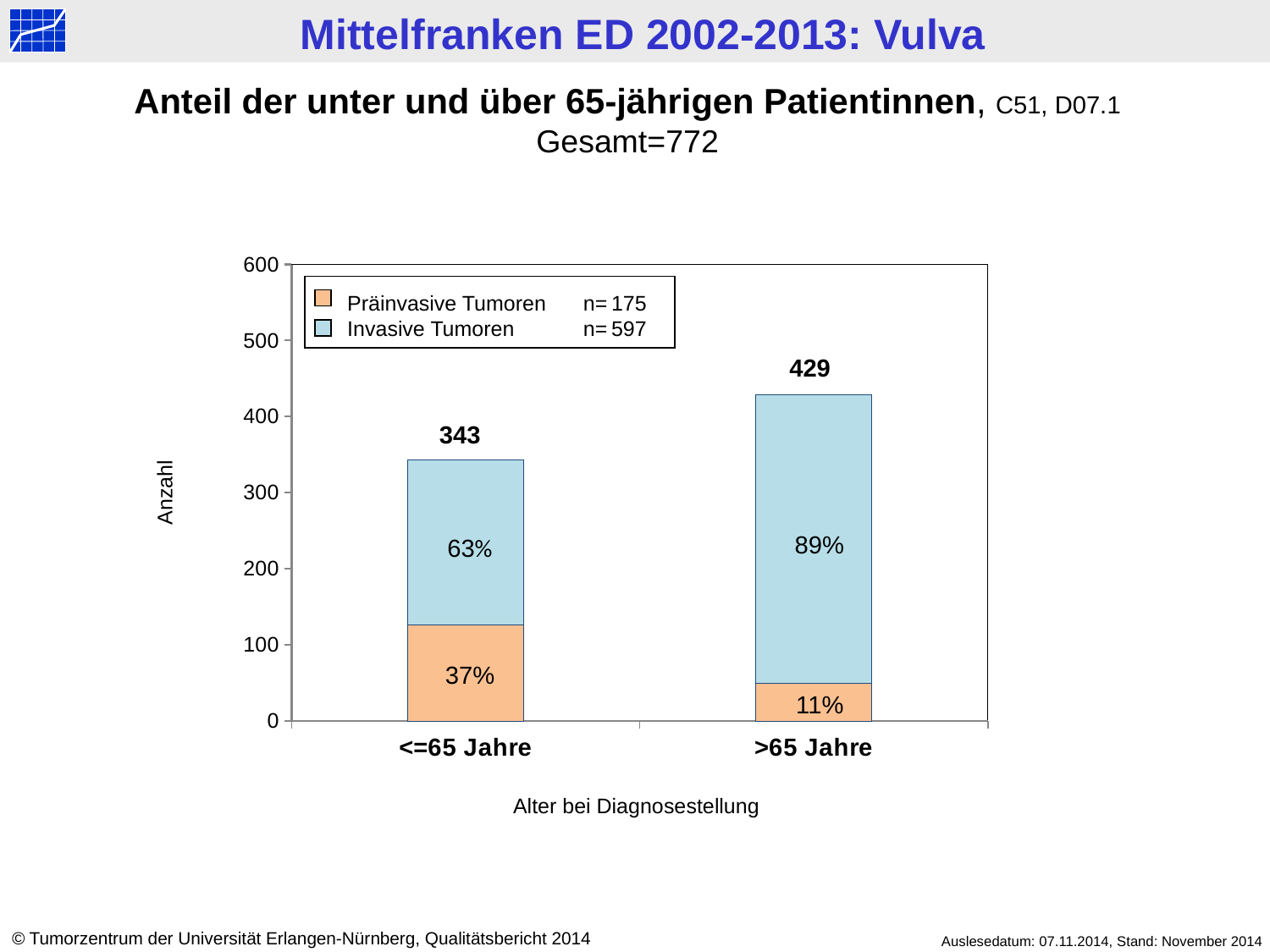
What is the difference between the totals of the >65 Jahre and <=65 Jahre bars? 86 What is the total number of patients shown for the <=65 Jahre bar? 343 How many series does the legend list? 2 What kind of chart is shown on the slide? Stacked bar chart What percentage of the >65 Jahre bar is Präinvasive Tumoren? 11% What percentage of the <=65 Jahre bar is Präinvasive Tumoren? 37% How many age categories are shown on the x axis? 2 Is the total for the <=65 Jahre bar greater or less than 400? less What percentage of the >65 Jahre bar is Invasive Tumoren? 89% Which age group has the higher total number of patients? >65 Jahre According to the legend, what is n for Invasive Tumoren? 597 What is the total number of patients shown for the >65 Jahre bar? 429